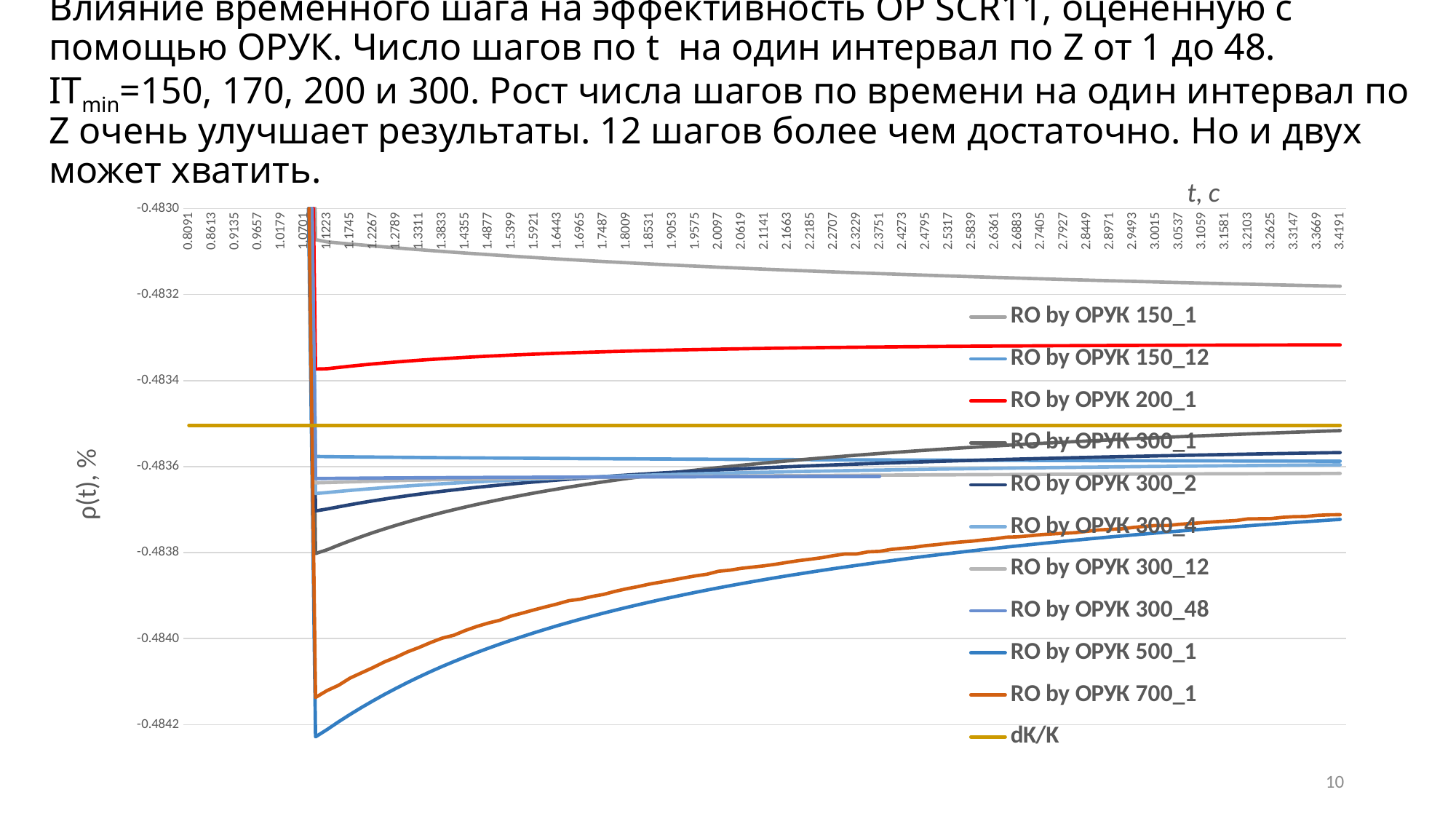
At the right end of the chart, which is larger: RO by ОРУК 150_1 or RO by ОРУК 500_1? RO by ОРУК 150_1 Is the value of RO by ОРУК 150_1 at the right end of the chart greater or less than -0.4832? greater Does RO by ОРУК 150_1 rise or fall as t increases? fall Is the value of the dK/K line greater or less than -0.4836? greater Which series is drawn as a horizontal (constant) line? dK/K Which series lies highest on the chart across the whole time range? RO by ОРУК 150_1 Is the value of RO by ОРУК 200_1 at the right end of the chart greater or less than -0.4834? greater Does RO by ОРУК 500_1 rise or fall as t increases after its initial drop? rise Which series reaches the lowest value on the chart? RO by ОРУК 500_1 What kind of chart is shown on the slide? line chart How many series does the legend list? 11 At the right end of the chart, which is larger: RO by ОРУК 200_1 or RO by ОРУК 700_1? RO by ОРУК 200_1